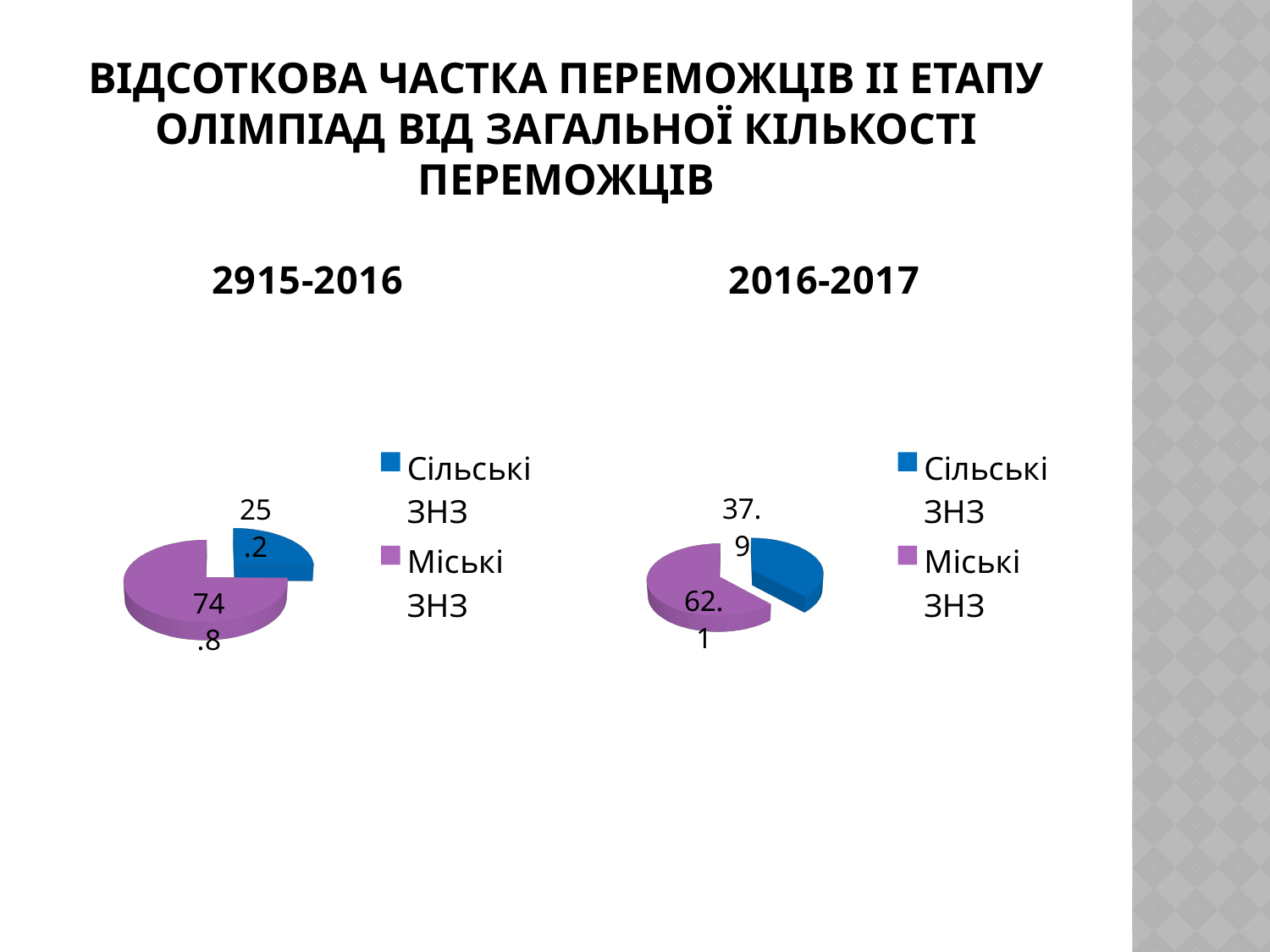
How many slices does the 2016-2017 pie chart have? 2 In the 2016-2017 chart, what colour is the Міські ЗНЗ slice? Purple Which is larger: the value for Сільські ЗНЗ in the 2915-2016 chart or in the 2016-2017 chart? 2016-2017 In the 2016-2017 chart, what is the difference between the values for Міські ЗНЗ and Сільські ЗНЗ? 24.2 In the 2016-2017 chart, which category has the smallest slice? Сільські ЗНЗ In the 2016-2017 chart, what is the value for Сільські ЗНЗ? 37.9 What type of chart is the 2915-2016 chart? Pie chart In the 2915-2016 chart, what is the value for Міські ЗНЗ? 74.8 In the 2915-2016 chart, what is the value for Сільські ЗНЗ? 25.2 In the 2016-2017 chart, what is the value for Міські ЗНЗ? 62.1 In the 2915-2016 chart, which category has the largest slice? Міські ЗНЗ In the 2915-2016 chart, what is the difference between the values for Міські ЗНЗ and Сільські ЗНЗ? 49.6